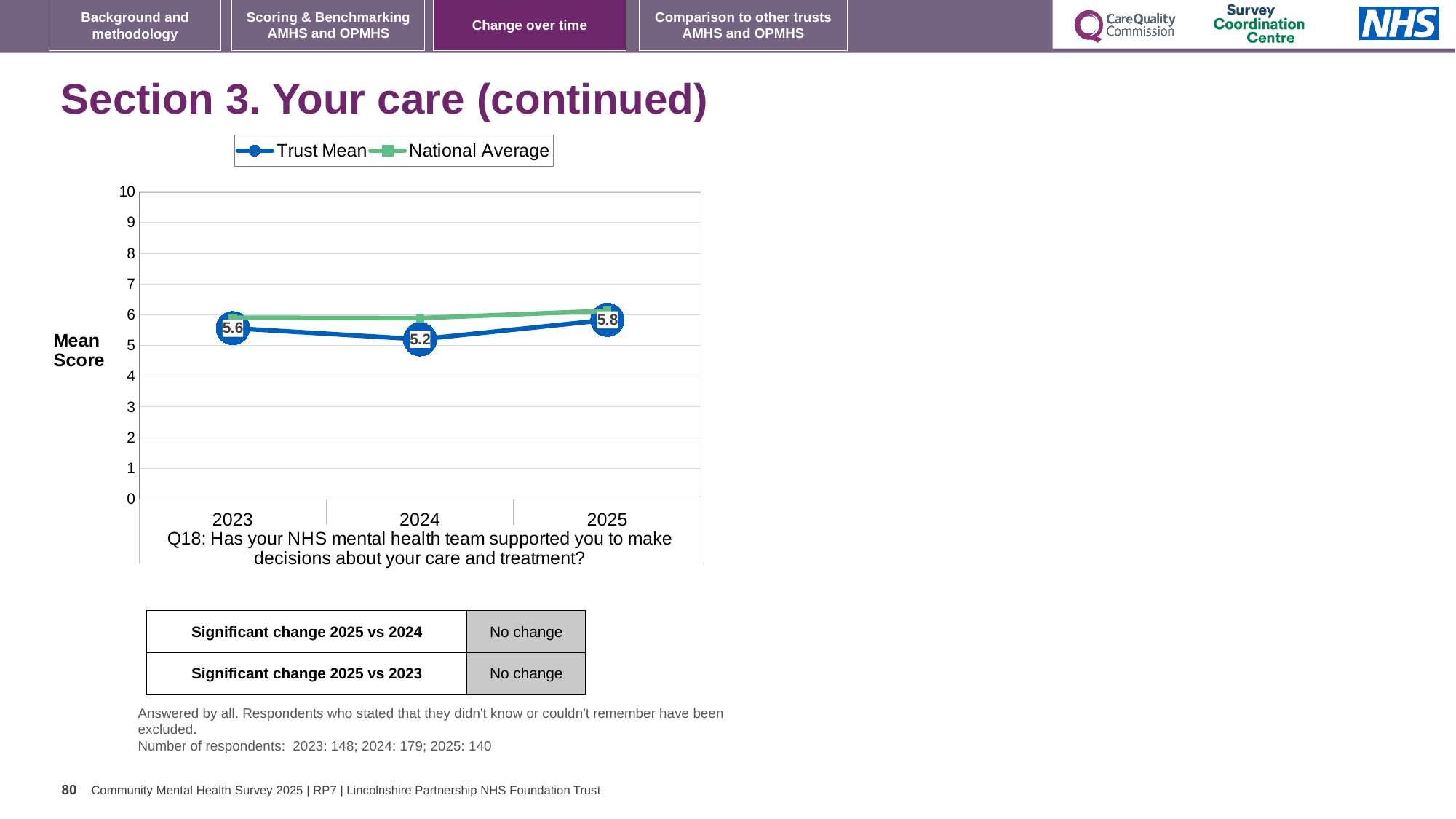
Is the National Average value for 2023 greater or less than 5? greater What is the Trust Mean score for 2023? 5.6 Does the Trust Mean rise or fall from 2023 to 2024? Fall Which is larger in 2024, the Trust Mean or the National Average? National Average In which year is the Trust Mean highest? 2025 What is the Trust Mean score for 2024? 5.2 How many series does the legend list? 2 By how much did the Trust Mean change from 2024 to 2025? 0.6 In which year is the Trust Mean lowest? 2024 How many years are plotted on the x axis? 3 What is the Trust Mean score for 2025? 5.8 What kind of chart is shown on the slide? Line chart